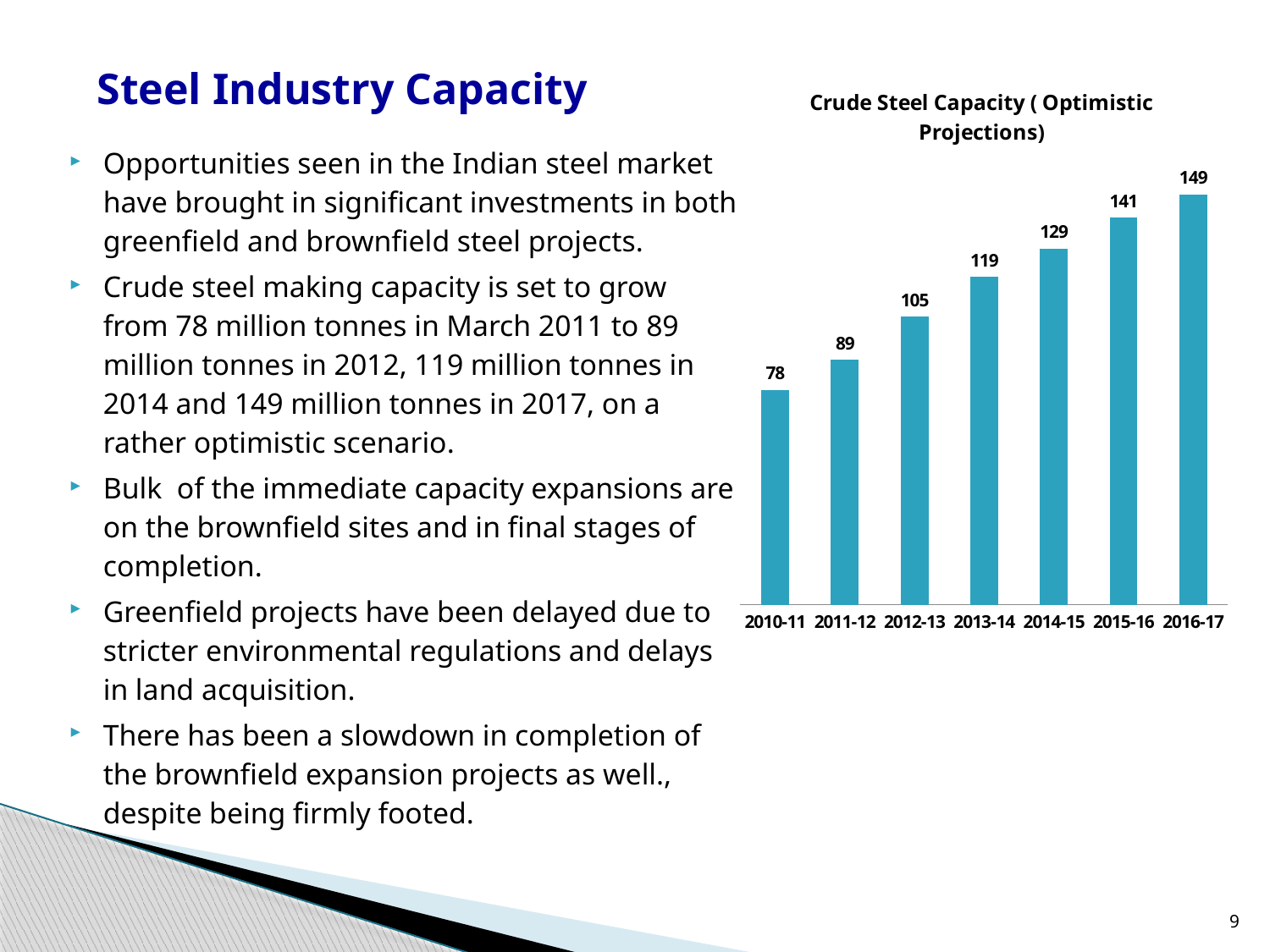
Which is larger, the value for 2014-15 or the value for 2012-13? 2014-15 What is the title of the chart on the slide? Crude Steel Capacity ( Optimistic Projections) How many years (bars) are shown in the chart? 7 What is the difference between the values for 2012-13 and 2011-12? 16 What is the value shown for 2013-14 in the Crude Steel Capacity chart? 119 What is the crude steel capacity value shown for 2010-11? 78 What type of chart is shown on the slide? Bar chart Which year has the lowest crude steel capacity in the chart? 2010-11 What is the difference between the values for 2016-17 and 2010-11? 71 Which year has the highest crude steel capacity in the chart? 2016-17 What is the value shown for 2015-16? 141 Do the values rise or fall from 2010-11 to 2016-17? Rise